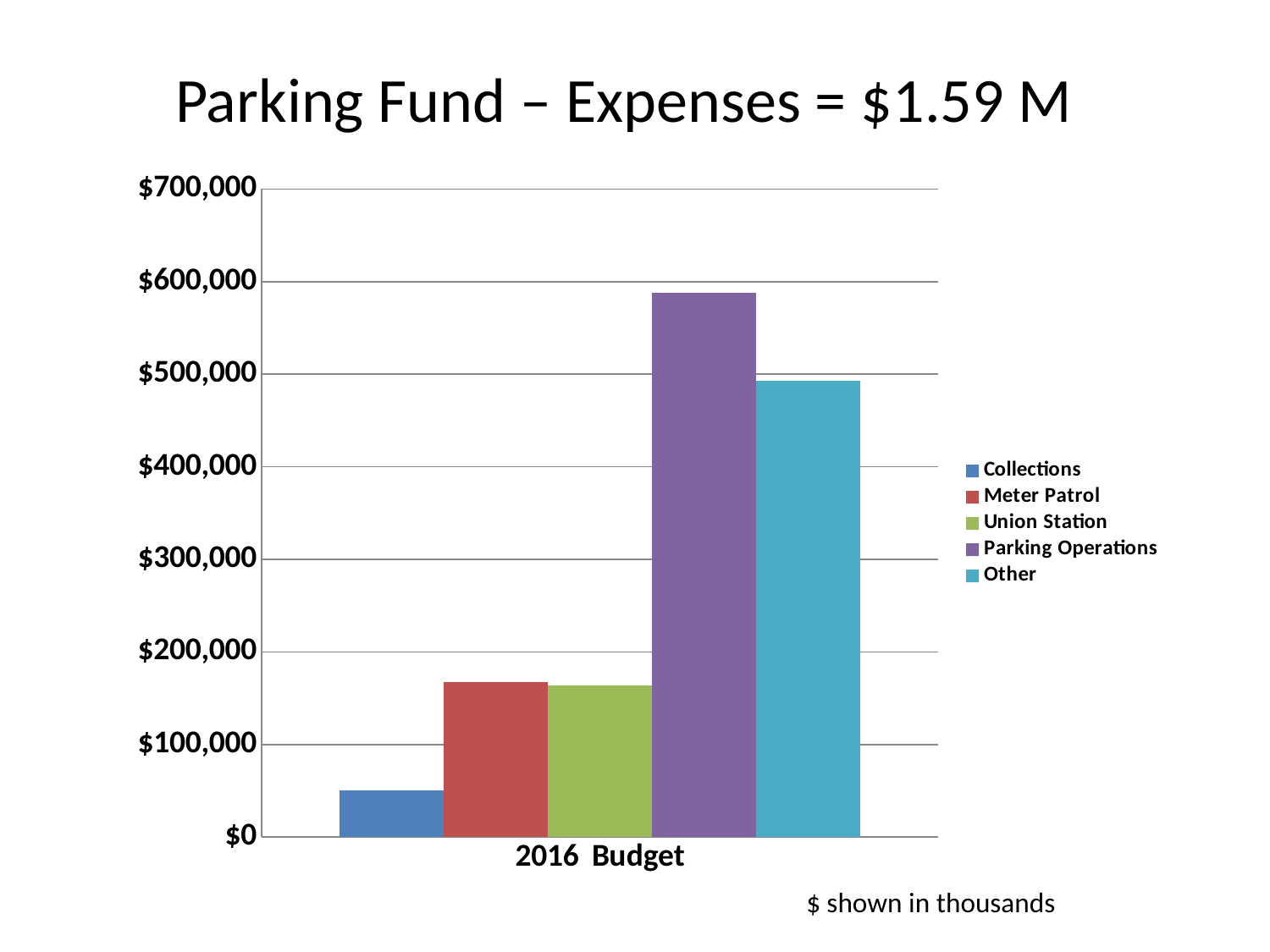
Is the value for Collections greater or less than $100,000? less How many series does the legend list? 5 Is the value for Other greater or less than $400,000? greater What kind of chart is shown on the slide? bar chart Is the value for Union Station greater or less than $100,000? greater Which series has the lowest value in the 2016 Budget? Collections What is the title of the chart on the slide? Parking Fund – Expenses = $1.59 M Which is larger, the value for Collections or the value for Meter Patrol? Meter Patrol Which series has the highest value in the 2016 Budget? Parking Operations Which is larger, the value for Parking Operations or the value for Other? Parking Operations